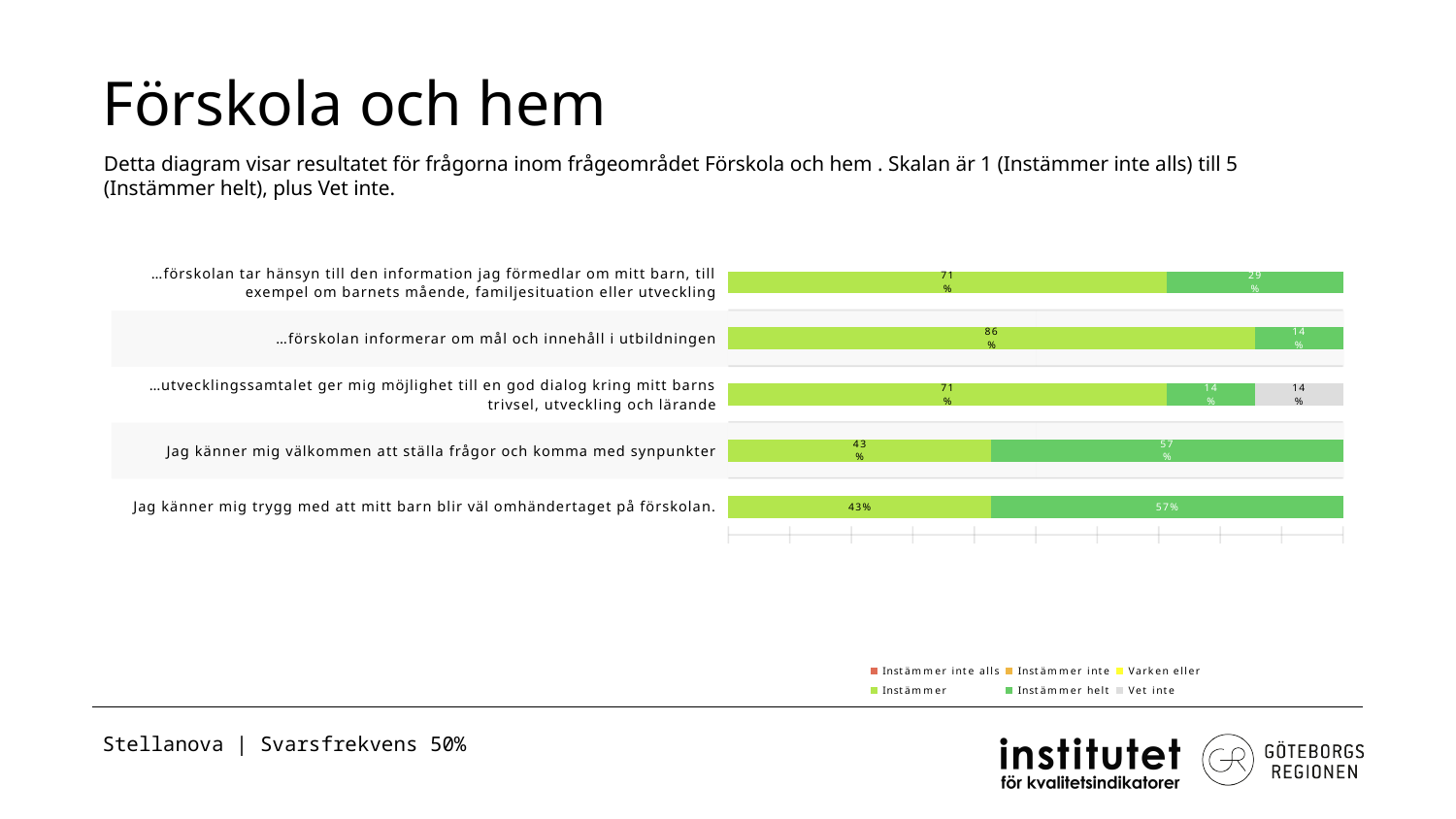
Which is larger for "Jag känner mig välkommen att ställa frågor och komma med synpunkter": the Instämmer value or the Instämmer helt value? Instämmer helt What is the Instämmer helt value for "Jag känner mig välkommen att ställa frågor och komma med synpunkter"? 57% How many questions (categories) are plotted in the chart? 5 What is the Vet inte value for "…utvecklingssamtalet ger mig möjlighet till en god dialog kring mitt barns trivsel, utveckling och lärande"? 14% Which question has the highest Instämmer value? …förskolan informerar om mål och innehåll i utbildningen Which legend entry is shown in grey? Vet inte What is the Instämmer value for "Jag känner mig trygg med att mitt barn blir väl omhändertaget på förskolan."? 43% How many series does the legend list? 6 What is the difference between the Instämmer value and the Instämmer helt value for "…förskolan tar hänsyn till den information jag förmedlar om mitt barn, till exempel om barnets mående, familjesituation eller utveckling"? 42% What is the Instämmer value for "…förskolan informerar om mål och innehåll i utbildningen"? 86% What kind of chart is shown on the slide? Stacked bar chart